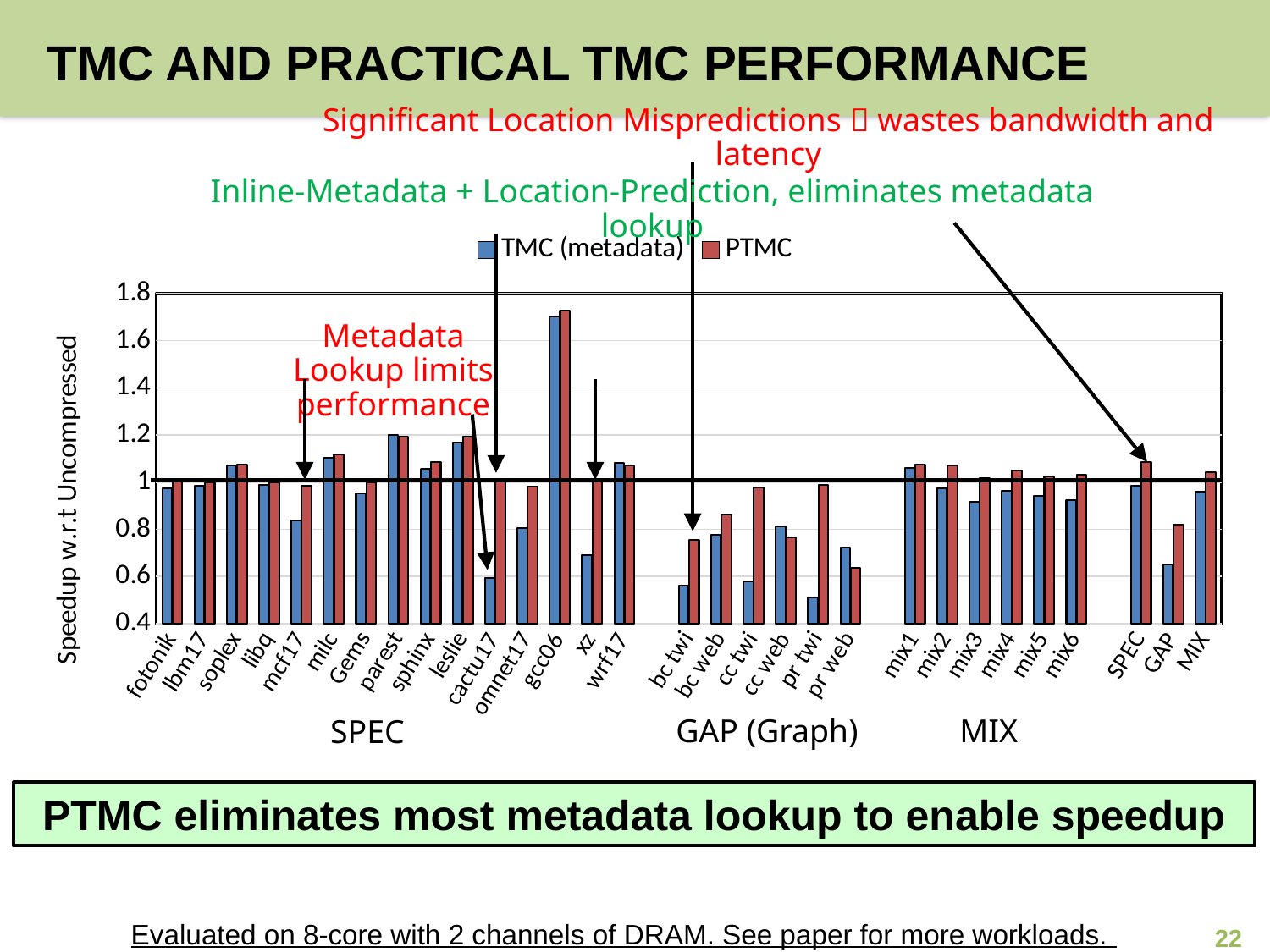
Is the TMC (metadata) value for cactu17 greater or less than 0.8? less Is the TMC (metadata) value for xz greater or less than 0.8? less How many series does the chart legend list? 2 Which workload has the highest PTMC speedup? gcc06 What is the label of the y axis? Speedup w.r.t Uncompressed For cactu17, which series has the larger value, TMC (metadata) or PTMC? PTMC Is the PTMC value for GAP greater or less than 1? less How many workload categories are plotted along the x axis? 30 Which workload has the highest TMC (metadata) speedup? gcc06 For bc twi, which series has the larger value, TMC (metadata) or PTMC? PTMC What kind of chart is shown on the slide? bar chart